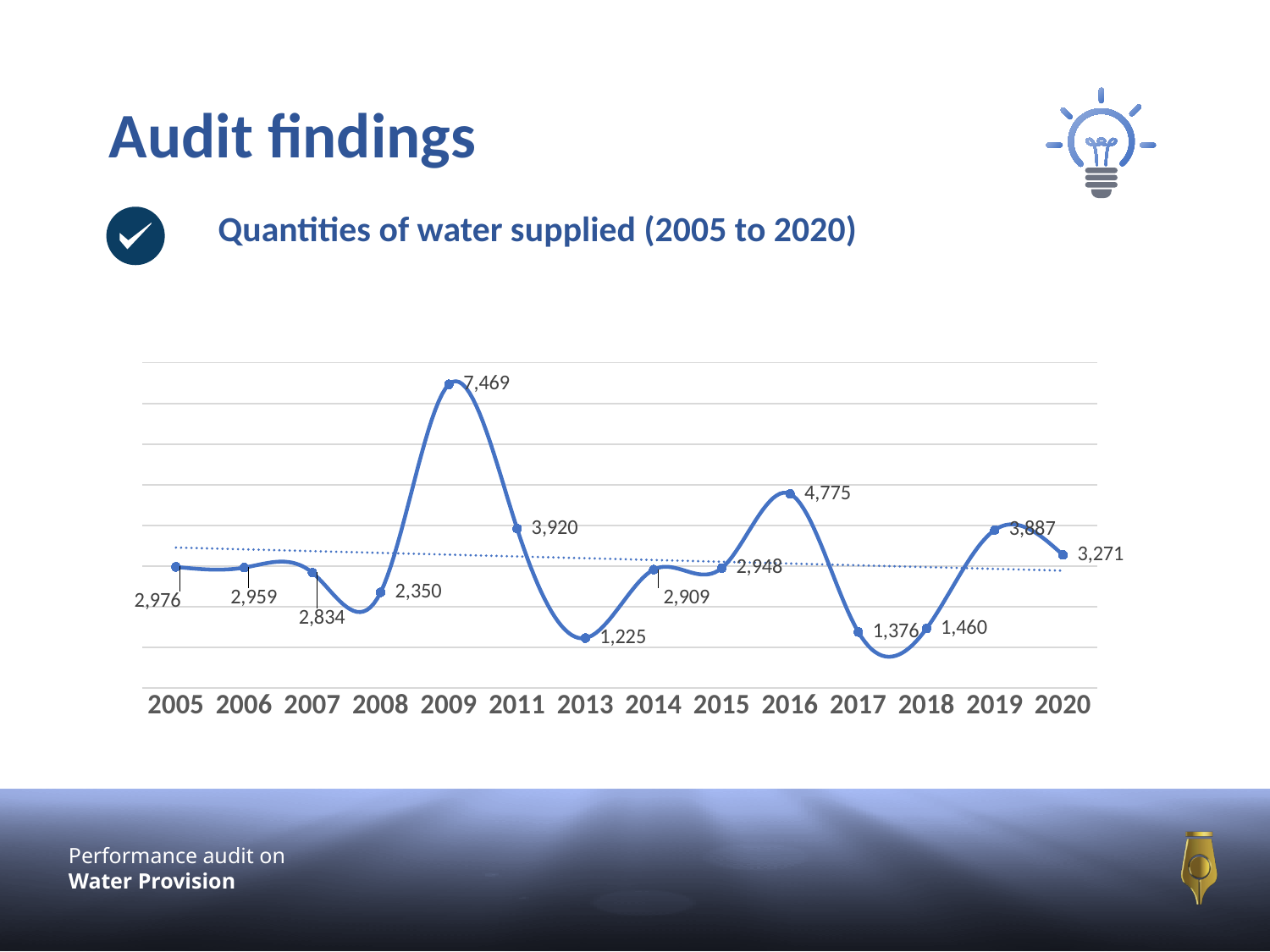
What kind of chart is shown on the slide? Line chart What quantity of water was supplied in 2020? 3,271 What quantity of water was supplied in 2009? 7,469 What is the value plotted for 2013? 1,225 Which year has the larger value, 2011 or 2019? 2011 Does the value rise or fall from 2019 to 2020? Fall What is the difference between the values for 2018 and 2017? 84 What is the value shown for 2016? 4,775 Which year has the lowest quantity of water supplied? 2013 What is the difference between the values for 2009 and 2016? 2,694 How many years are plotted on the x axis? 14 Which year has the highest quantity of water supplied? 2009